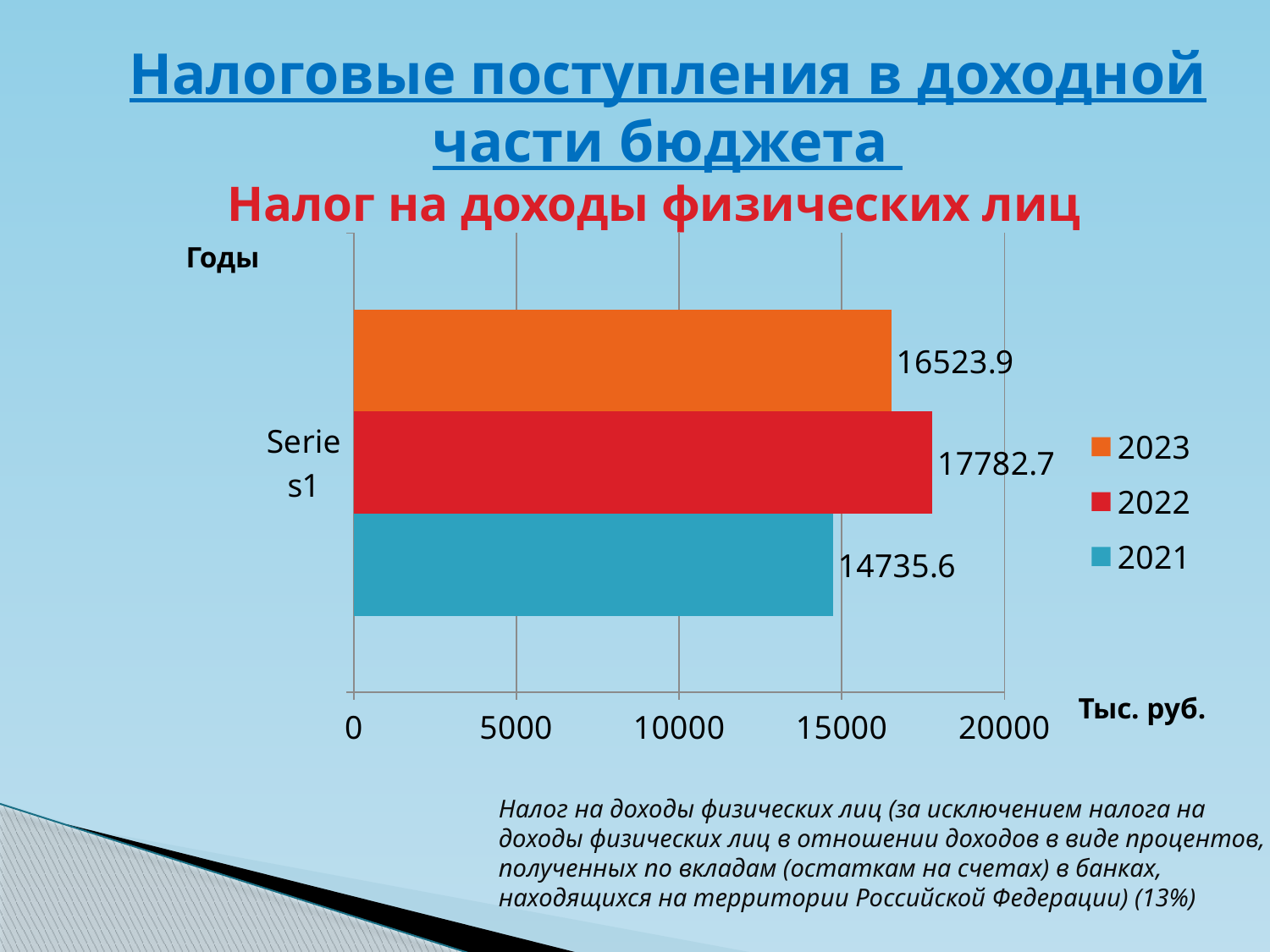
What is the value for 2021? 14735.6 What kind of chart is shown on the slide? bar chart What unit label is shown next to the horizontal axis? Тыс. руб. What is the value for 2023? 16523.9 What is the difference between the values for 2022 and 2023? 1258.8 Is the value for 2021 greater or less than 15000? less What is the difference between the values for 2022 and 2021? 3047.1 Which is larger, the value for 2023 or the value for 2021? 2023 How many series does the legend list? 3 What is the value for 2022? 17782.7 Which year has the highest value? 2022 Which year has the lowest value? 2021